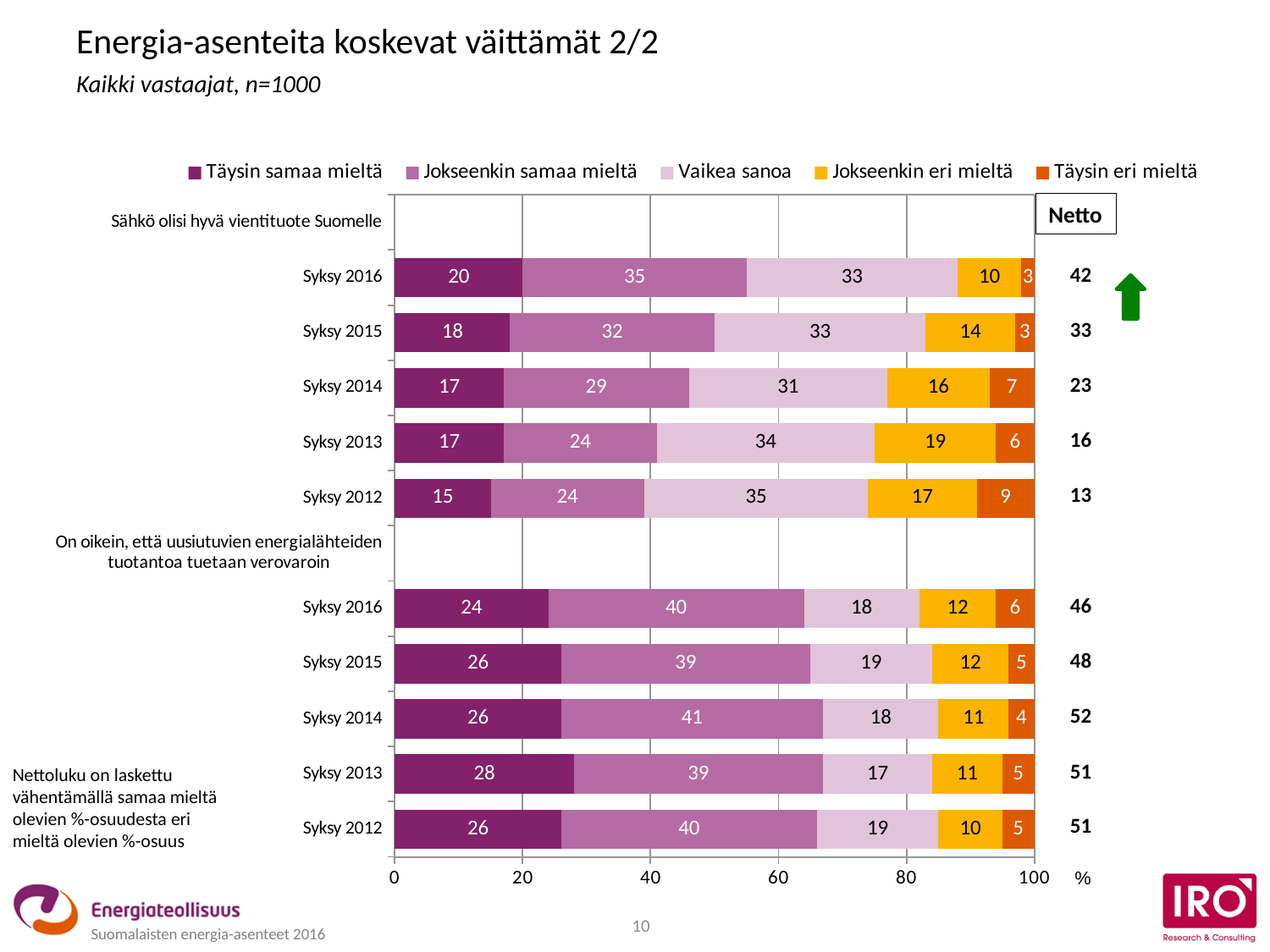
What is the value of "Täysin samaa mieltä" for Syksy 2016 under the statement "Sähkö olisi hyvä vientituote Suomelle"? 20 What kind of chart is shown on the slide? Stacked bar chart How many series does the legend list? 5 What is the value of "Jokseenkin samaa mieltä" for Syksy 2014 under the statement "On oikein, että uusiutuvien energialähteiden tuotantoa tuetaan verovaroin"? 41 How many survey years are shown for each statement? 5 What is the Netto value for Syksy 2016 under the statement "Sähkö olisi hyvä vientituote Suomelle"? 42 What is the value of "Vaikea sanoa" for Syksy 2013 under the statement "On oikein, että uusiutuvien energialähteiden tuotantoa tuetaan verovaroin"? 17 Under the statement "Sähkö olisi hyvä vientituote Suomelle", which year has the highest "Täysin samaa mieltä" value? Syksy 2016 What is the total of the stacked bar for Syksy 2012 under the statement "Sähkö olisi hyvä vientituote Suomelle"? 100 Which bar has the lowest Netto value on the slide? Syksy 2012 under "Sähkö olisi hyvä vientituote Suomelle" (13) Under the statement "Sähkö olisi hyvä vientituote Suomelle", which has the larger "Täysin eri mieltä" value, Syksy 2012 or Syksy 2014? Syksy 2012 Under the statement "Sähkö olisi hyvä vientituote Suomelle", what is the difference between the "Jokseenkin eri mieltä" values for Syksy 2015 and Syksy 2016? 4